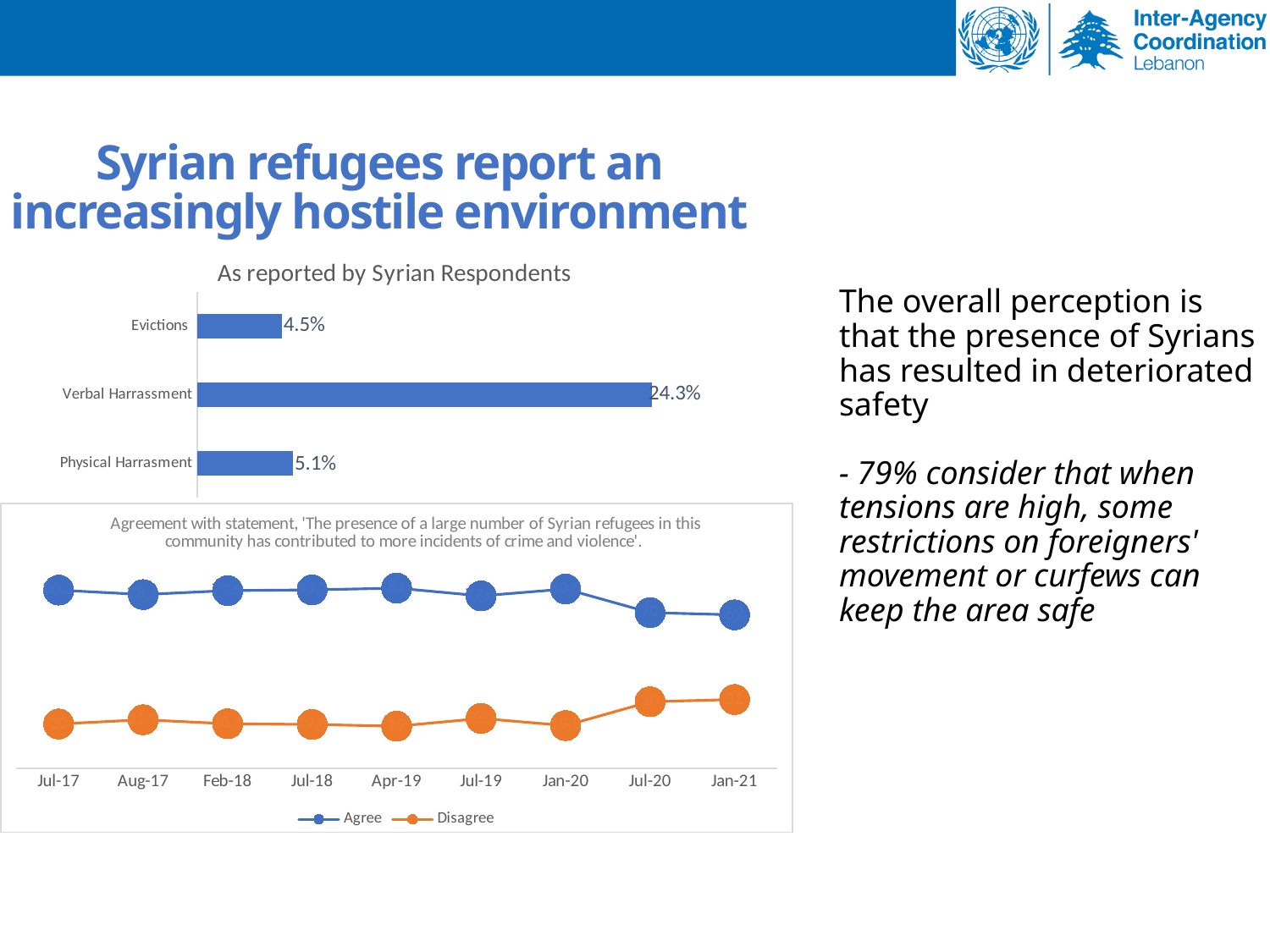
In the bottom chart about agreement with the statement on crime and violence, how many time points are shown on the x axis? 9 In the bottom chart about agreement with the statement on crime and violence, how many series does the legend list? 2 In the chart titled 'As reported by Syrian Respondents', which category has the lowest value? Evictions In the chart titled 'As reported by Syrian Respondents', what is the difference between the values for Verbal Harrassment and Physical Harrasment? 19.2% What kind of chart is the chart titled 'As reported by Syrian Respondents'? Bar chart In the chart titled 'As reported by Syrian Respondents', which category has the highest value? Verbal Harrassment In the chart titled 'As reported by Syrian Respondents', which is larger, the value for Physical Harrasment or the value for Evictions? Physical Harrasment In the chart titled 'As reported by Syrian Respondents', what is the value for Physical Harrasment? 5.1% In the bottom chart about agreement with the statement on crime and violence, which series is higher at Jan-21, Agree or Disagree? Agree In the chart titled 'As reported by Syrian Respondents', what is the value for Verbal Harrassment? 24.3% In the chart titled 'As reported by Syrian Respondents', how many categories are shown? 3 In the chart titled 'As reported by Syrian Respondents', what is the value for Evictions? 4.5%